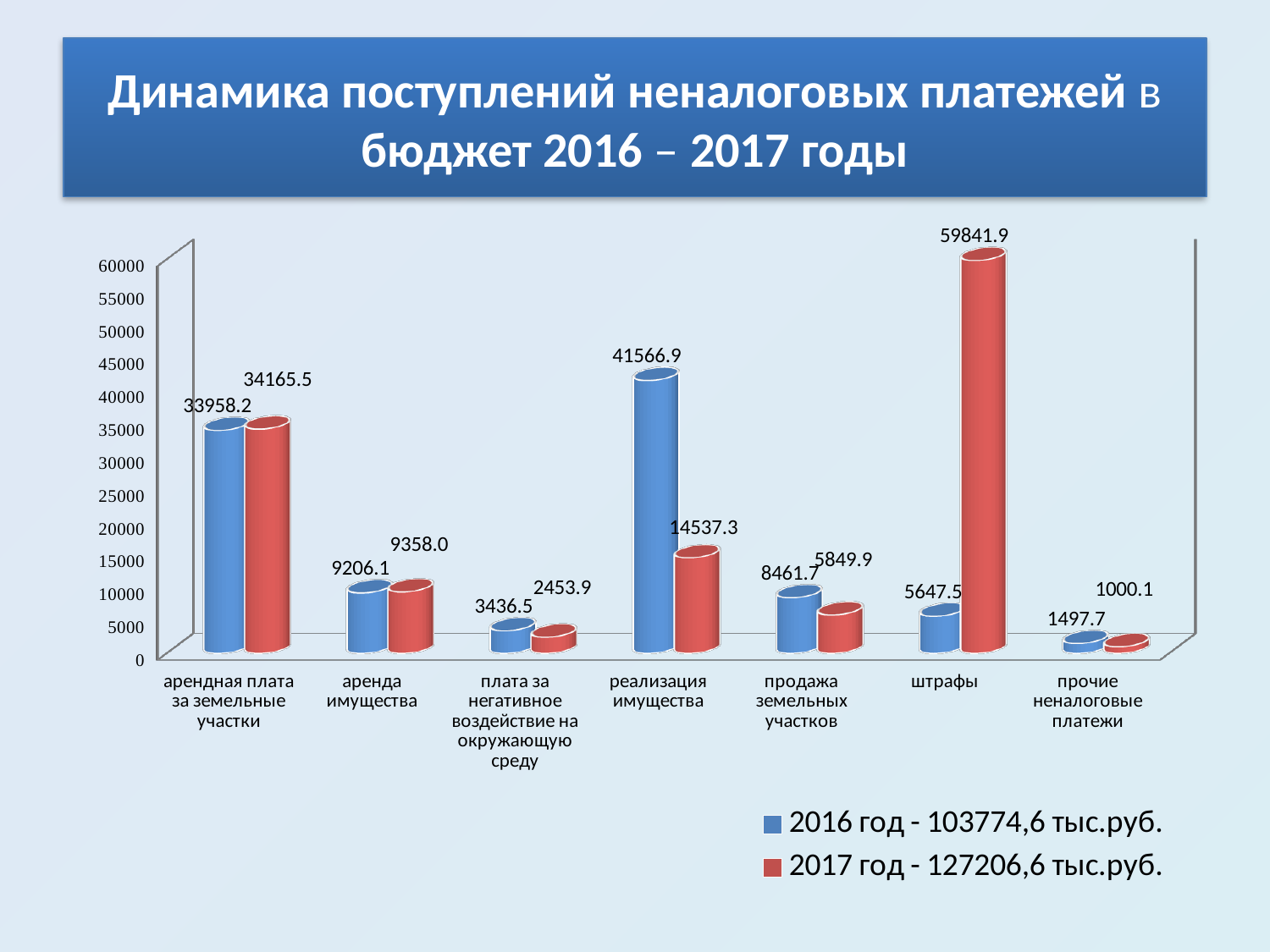
Which is larger for продажа земельных участков, the 2016 value or the 2017 value? 2016 What is the difference between the 2016 and 2017 values for реализация имущества? 27029.6 Which colour represents the 2017 series? red What is the 2016 value for штрафы? 5647.5 What is the difference between the 2017 and 2016 values for штрафы? 54194.4 How many series does the legend list? 2 What is the 2016 value for аренда имущества? 9206.1 What kind of chart is shown on the slide? bar chart Which category has the lowest 2016 value? прочие неналоговые платежи How many categories are shown on the x axis? 7 Which category has the highest 2017 value? штрафы What is the 2017 value for реализация имущества? 14537.3